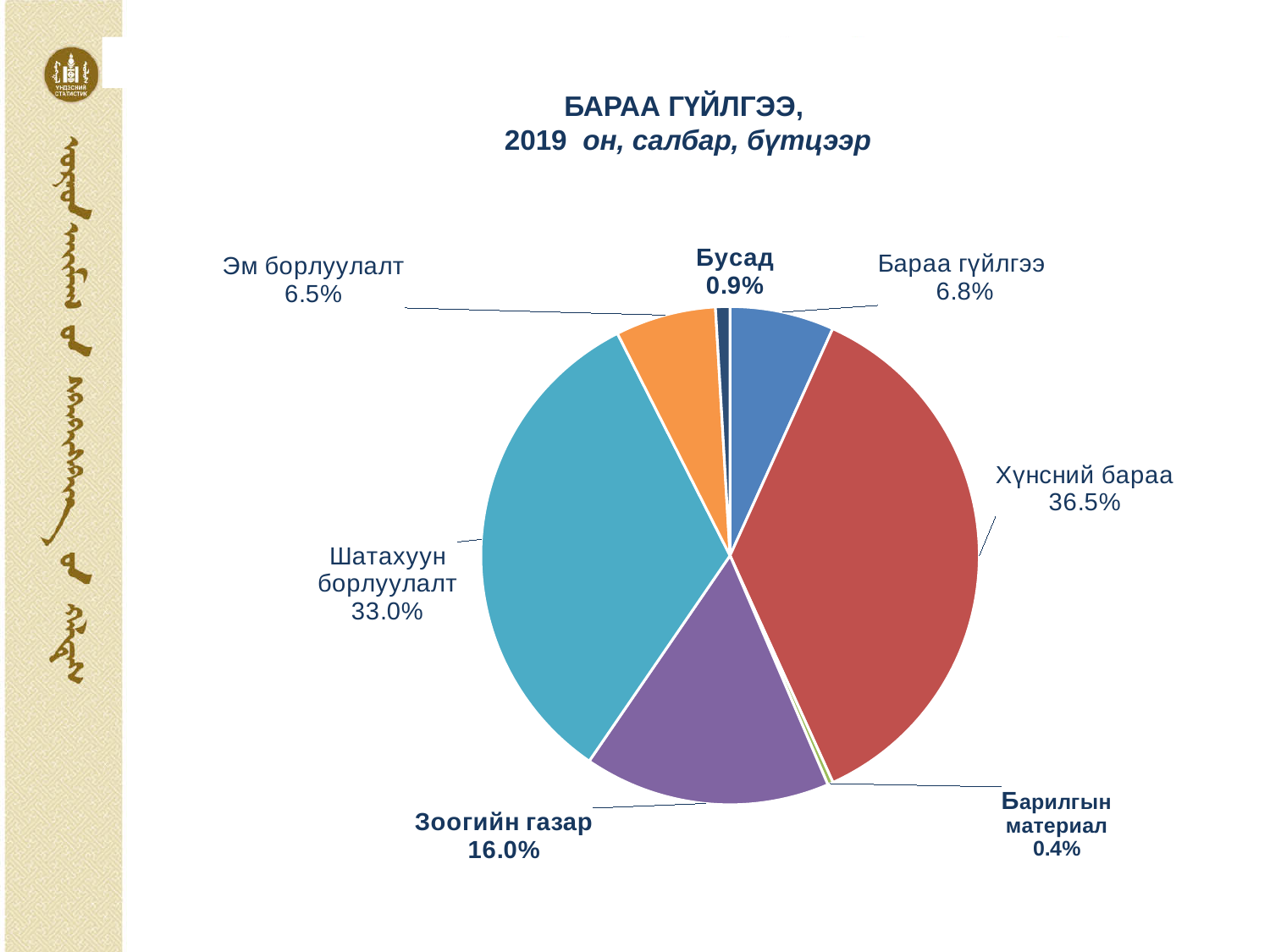
What share does Хүнсний бараа have in the pie chart? 36.5% What share does Бусад have in the pie chart? 0.9% What share does Зоогийн газар have in the pie chart? 16.0% Which is larger, the share of Бараа гүйлгээ or the share of Эм борлуулалт? Бараа гүйлгээ What share does Шатахуун борлуулалт have in the pie chart? 33.0% Which category has the largest share in the pie chart? Хүнсний бараа What share does Барилгын материал have in the pie chart? 0.4% What type of chart is shown on the slide? pie chart Which category has the smallest share in the pie chart? Барилгын материал How many slices does the pie chart have? 7 What is the difference in percentage points between Хүнсний бараа and Шатахуун борлуулалт? 3.5 What year is given in the chart title? 2019